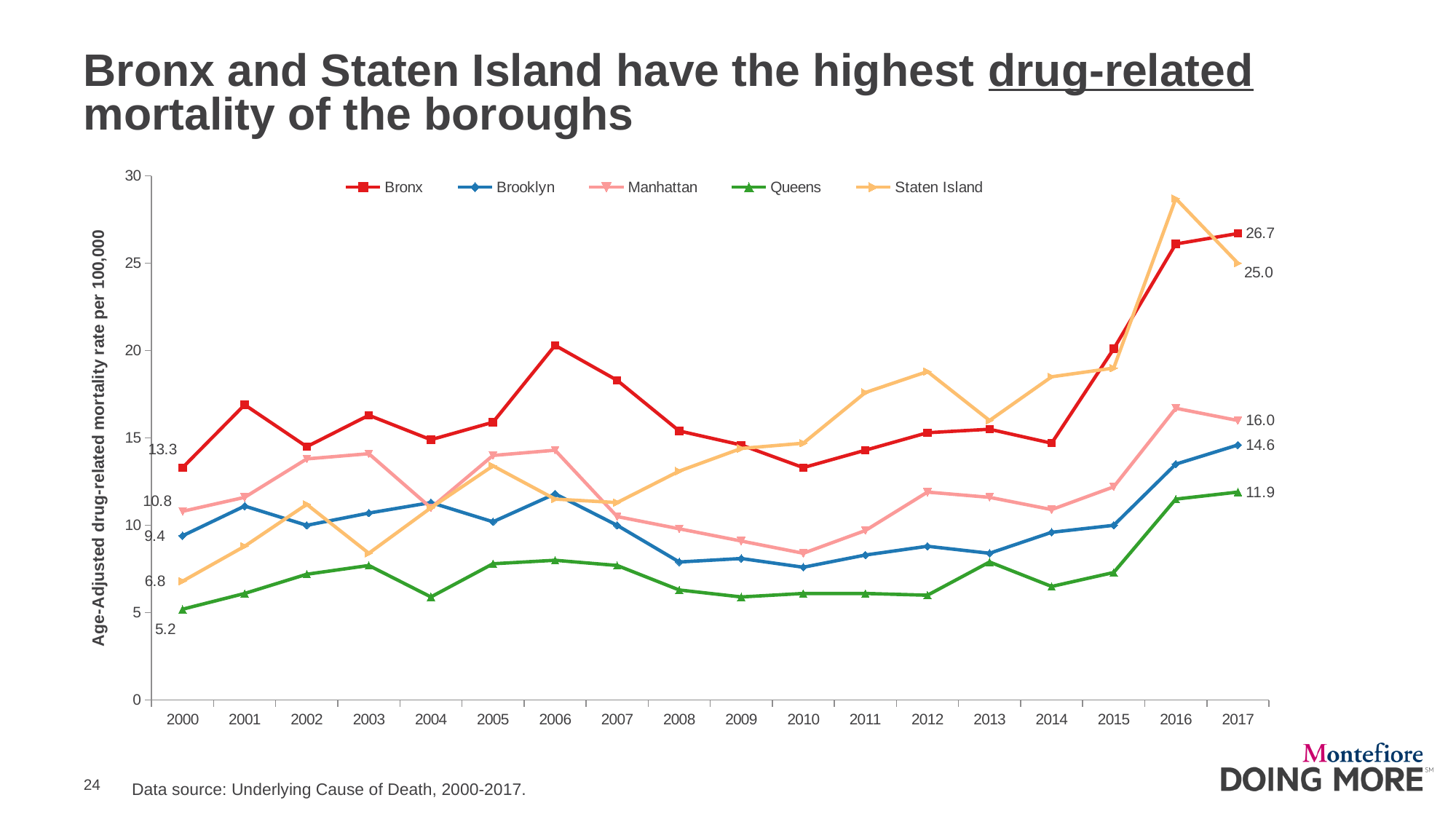
Which borough has the lowest value in 2017? Queens How many series does the legend list? 5 By how much did the Bronx rate increase from 2000 to 2017? 13.4 What is the value for Staten Island in 2017? 25.0 Is the value for Staten Island in 2016 greater or less than 25? greater How many years are plotted on the x axis? 18 What is the value for Manhattan in 2000? 10.8 Which borough has the highest value in 2017? Bronx What is the value for Queens in 2000? 5.2 What is the age-adjusted drug-related mortality rate for the Bronx in 2017? 26.7 Which is larger in 2017, the value for Manhattan or the value for Brooklyn? Manhattan What kind of chart is shown on the slide? line chart